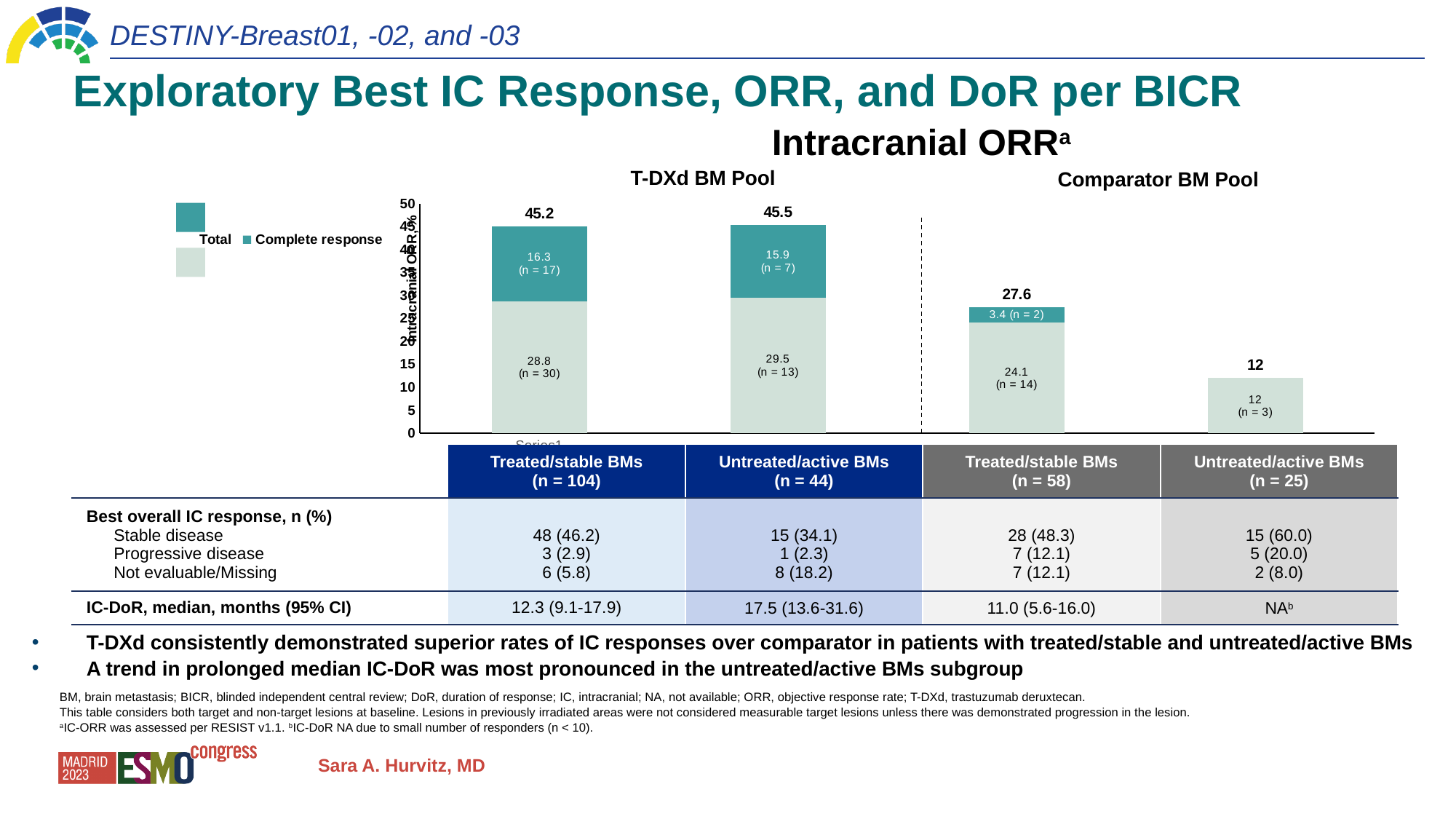
How many bars are shown in the Intracranial ORR chart? 4 Which is larger: the total intracranial ORR for T-DXd untreated/active BMs or for Comparator untreated/active BMs? T-DXd untreated/active BMs Which group has the lowest total intracranial ORR? Comparator BM Pool untreated/active BMs What is the complete response rate shown for the T-DXd BM Pool treated/stable BMs bar? 16.3 What type of chart is used to show Intracranial ORR? Stacked bar chart What is the maximum value shown on the y axis of the Intracranial ORR chart? 50 What is the total intracranial ORR for the T-DXd BM Pool untreated/active BMs group? 45.5 What is the complete response rate shown for the Comparator BM Pool treated/stable BMs bar? 3.4 What is the total intracranial ORR for the T-DXd BM Pool treated/stable BMs group? 45.2 What is the total intracranial ORR for the Comparator BM Pool treated/stable BMs group? 27.6 Is the total intracranial ORR for the Comparator BM Pool untreated/active BMs group greater or less than 15? less What is the difference in total intracranial ORR between the T-DXd treated/stable BMs group and the Comparator treated/stable BMs group? 17.6